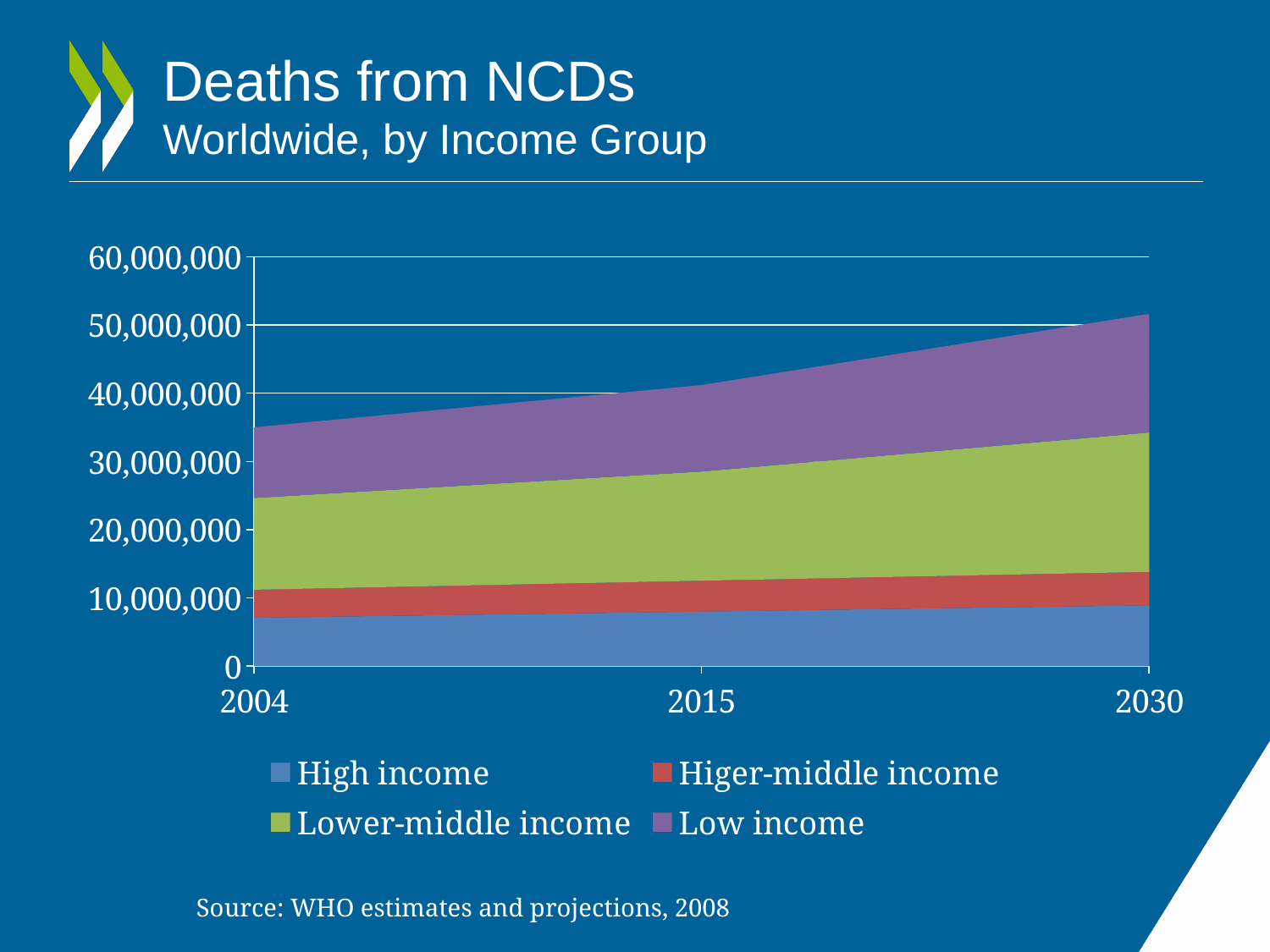
How many years are labelled on the x axis? 3 Is the value for High income in 2004 greater or less than 10,000,000? less Which series is the largest contributor to the total in 2030? Lower-middle income Is the total of all income groups in 2015 greater or less than 50,000,000? less Which series is the smallest contributor to the total in 2030? Higer-middle income Which years are labelled on the x axis? 2004, 2015, 2030 Do total deaths from NCDs rise or fall from 2004 to 2030? Rise Is the total of all income groups in 2030 greater or less than 50,000,000? greater How many series does the legend list? 4 Which income group is plotted as the bottom layer of the stacked area? High income What kind of chart is shown on the slide? Stacked area chart